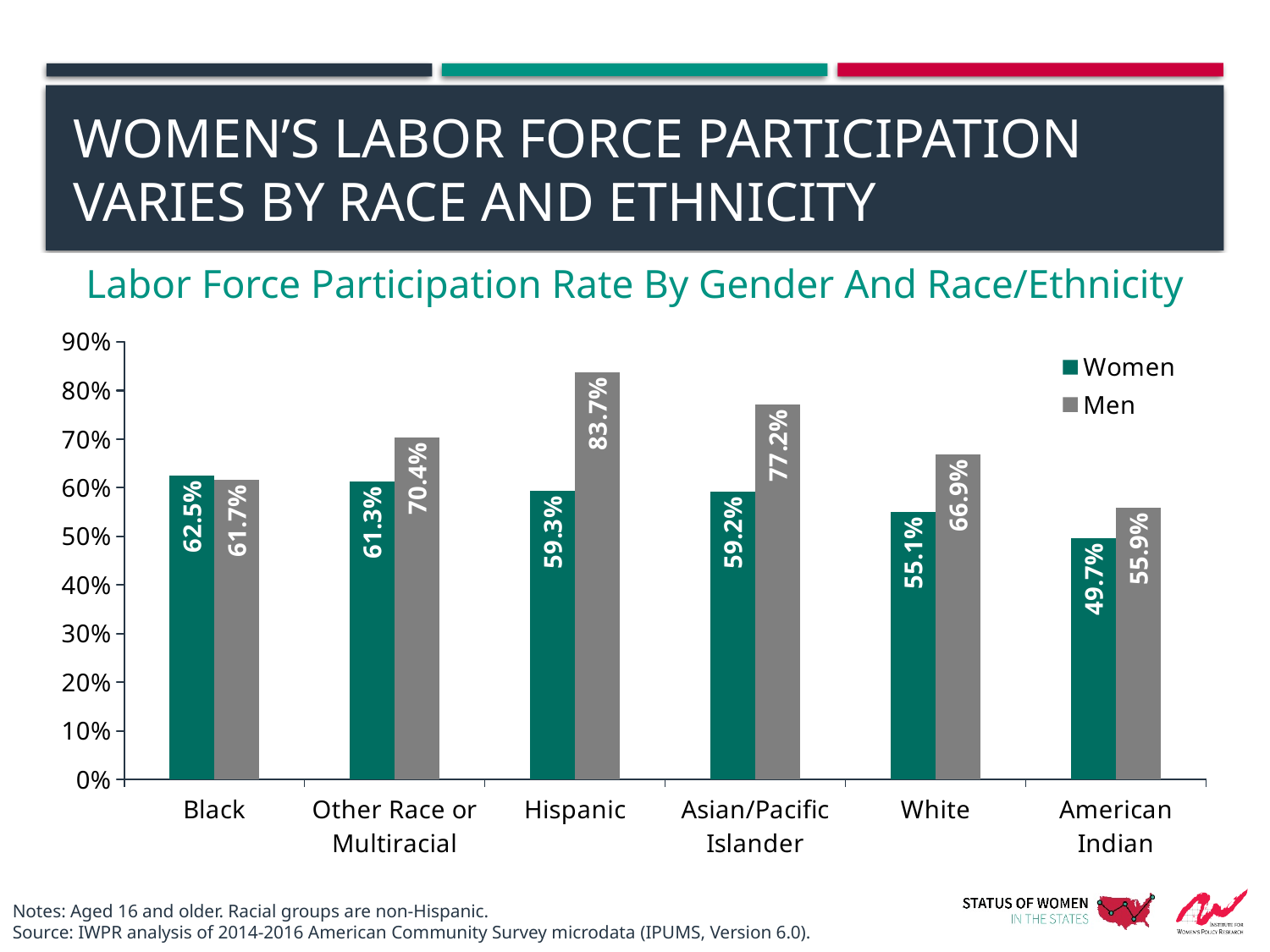
Which race/ethnicity group has the highest labor force participation rate for men? Hispanic How many race/ethnicity categories are shown on the x axis? 6 Which is larger, the labor force participation rate for Black women or Black men? Black women How many series does the legend list? 2 Is the labor force participation rate for Asian/Pacific Islander men greater or less than 70%? greater Which race/ethnicity group has the lowest labor force participation rate for women? American Indian What is the difference between the men's and women's labor force participation rates for Hispanic people? 24.4% What is the labor force participation rate for White men? 66.9% What is the labor force participation rate for American Indian women? 49.7% What colour are the bars for the Women series? Teal (green) What is the labor force participation rate for Hispanic women? 59.3% What kind of chart is shown on the slide? Bar chart